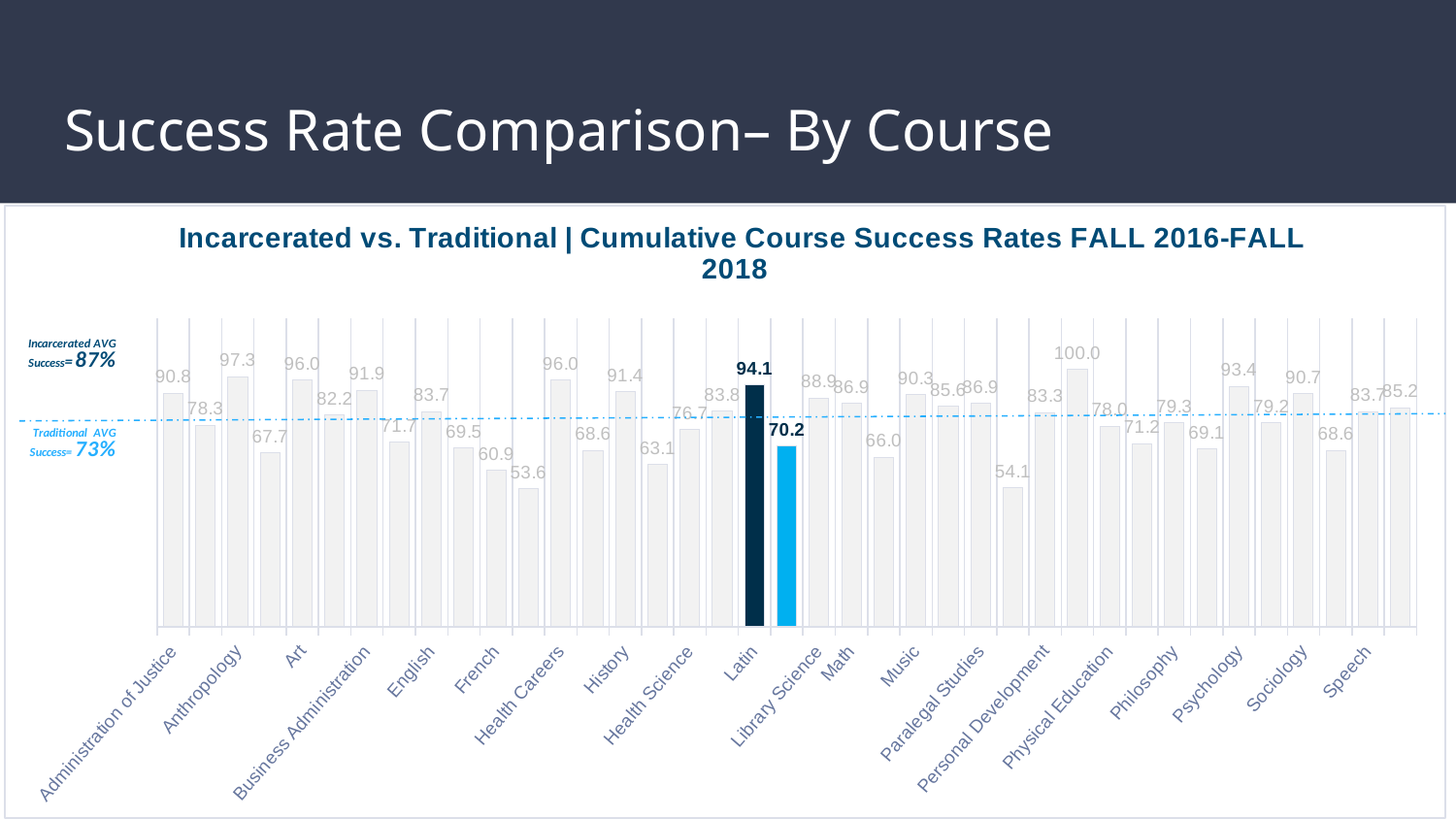
Is the traditional success rate for Latin greater or less than the Traditional AVG Success of 73%? less What is the first value labelled for Administration of Justice, the first course on the x axis? 90.8 What kind of chart is shown on the slide? bar chart For Latin, which is larger: the incarcerated success rate or the traditional success rate? incarcerated What is the Incarcerated AVG Success rate noted on the left of the chart? 87% What is the difference between the incarcerated and traditional success rates for Latin? 23.9 What is the traditional success rate for Latin (the light blue highlighted bar)? 70.2 How many courses are listed along the x axis of the chart? 20 What is the highest value labelled on any bar in the chart? 100.0 What is the lowest value labelled on any bar in the chart? 53.6 What is the incarcerated success rate for Latin (the dark highlighted bar)? 94.1 What is the title of the chart? Incarcerated vs. Traditional | Cumulative Course Success Rates FALL 2016-FALL 2018